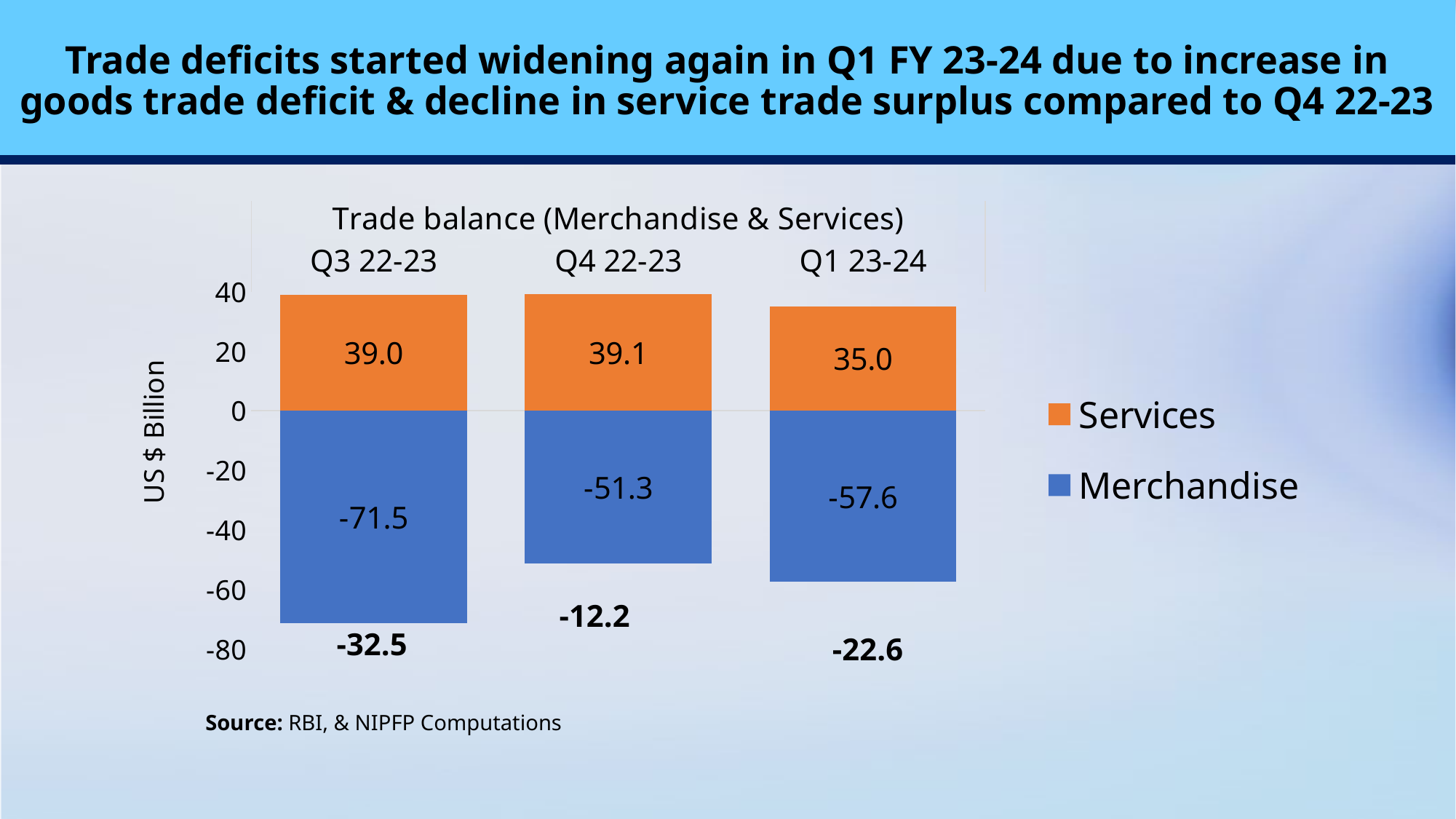
Which quarter has the lowest Merchandise value? Q3 22-23 What is the total trade balance shown for Q3 22-23? -32.5 What is the Services value for Q3 22-23? 39.0 What is the Merchandise value for Q4 22-23? -51.3 What kind of chart is shown on the slide? Stacked bar chart What is the Merchandise value for Q1 23-24? -57.6 What is the difference between the Services values for Q4 22-23 and Q1 23-24? 4.1 Which quarter has the lowest Services value? Q1 23-24 How many series does the legend list? 2 What is the total trade balance shown for Q4 22-23? -12.2 What is the Services value for Q1 23-24? 35.0 Is the Merchandise value for Q3 22-23 greater or less than -60? less